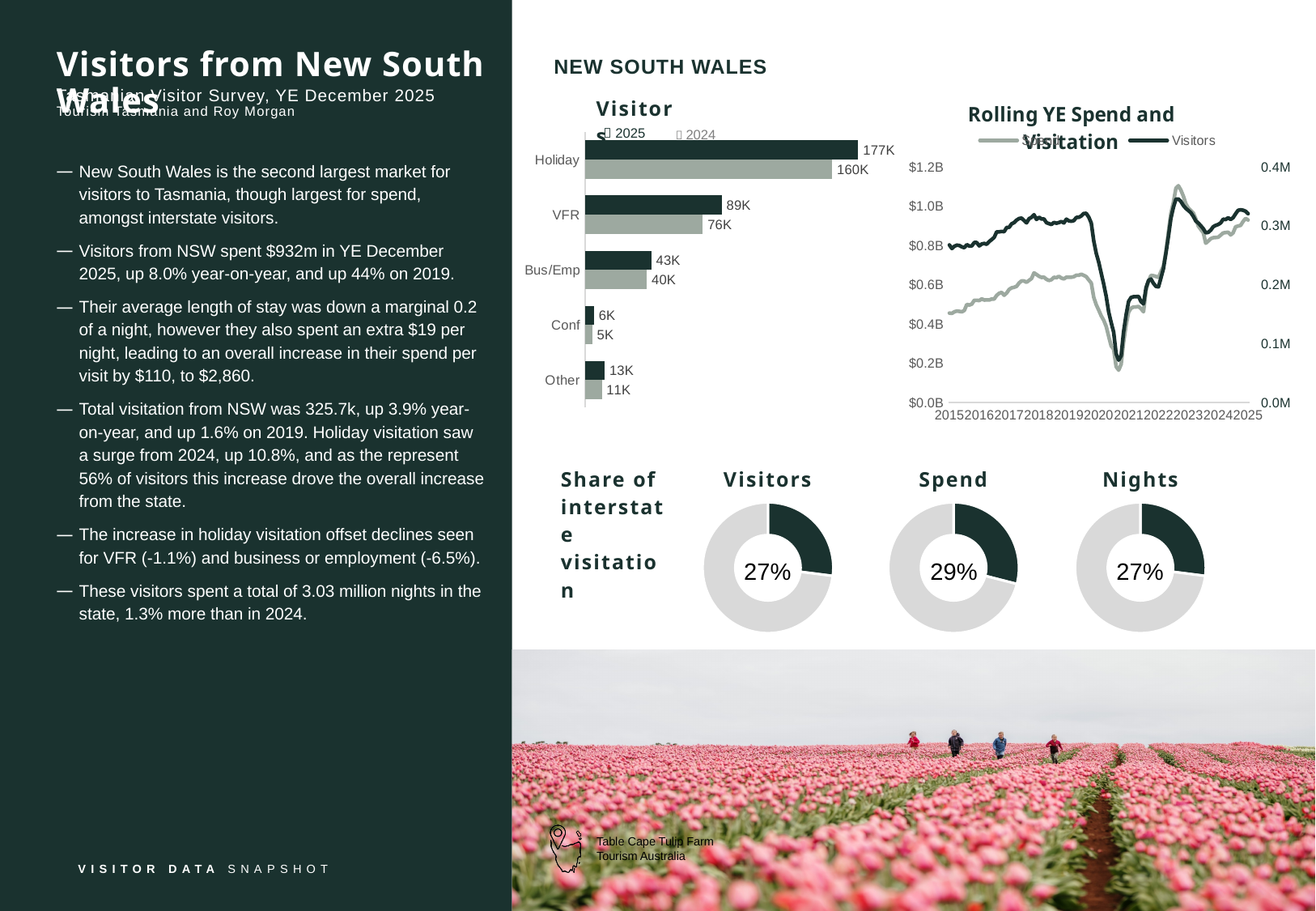
In the Visitors bar chart, what is the 2025 value for Bus/Emp? 43K In the Visitors bar chart, what is the difference between the 2025 and 2024 values for Holiday? 17K How many categories are shown in the Visitors bar chart? 5 How many series does the legend of the Visitors bar chart list? 2 In the Visitors bar chart, which category has the highest 2025 value? Holiday In the Share of interstate visitation donut charts, what is the share shown for Nights? 27% In the Visitors bar chart, what is the 2025 value for Holiday? 177K What kind of chart is the Rolling YE Spend and Visitation chart? Line chart In the Visitors bar chart, which category has the lowest 2024 value? Conf In the Visitors bar chart, what is the 2024 value for VFR? 76K In the Share of interstate visitation donut charts, what is the share shown for Spend? 29% In the Visitors bar chart, which is larger: the 2025 value for Other or the 2025 value for Conf? Other